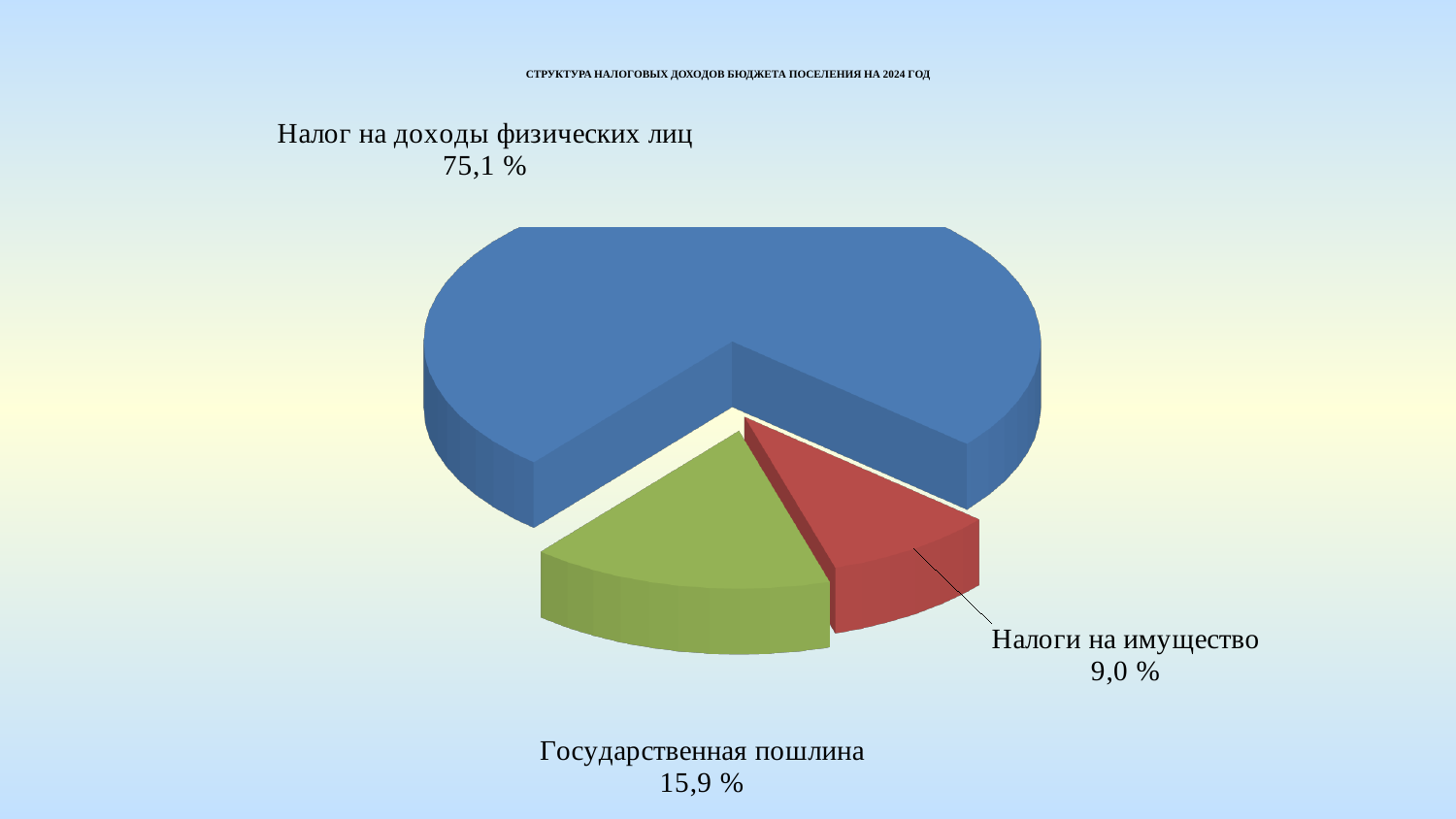
What kind of chart is shown on the slide? Pie chart What is the share for Налоги на имущество? 9,0 % What is the title of the chart? СТРУКТУРА НАЛОГОВЫХ ДОХОДОВ БЮДЖЕТА ПОСЕЛЕНИЯ НА 2024 ГОД What is the difference in percentage points between Налог на доходы физических лиц and Государственная пошлина? 59,2 Which category has the largest share of the pie? Налог на доходы физических лиц What colour is the slice for Налоги на имущество? Red Which is larger: the share for Государственная пошлина or the share for Налоги на имущество? Государственная пошлина What is the difference in percentage points between Государственная пошлина and Налоги на имущество? 6,9 Which category has the smallest share of the pie? Налоги на имущество How many slices does the pie chart have? 3 What is the share for Налог на доходы физических лиц? 75,1 % What is the share for Государственная пошлина? 15,9 %